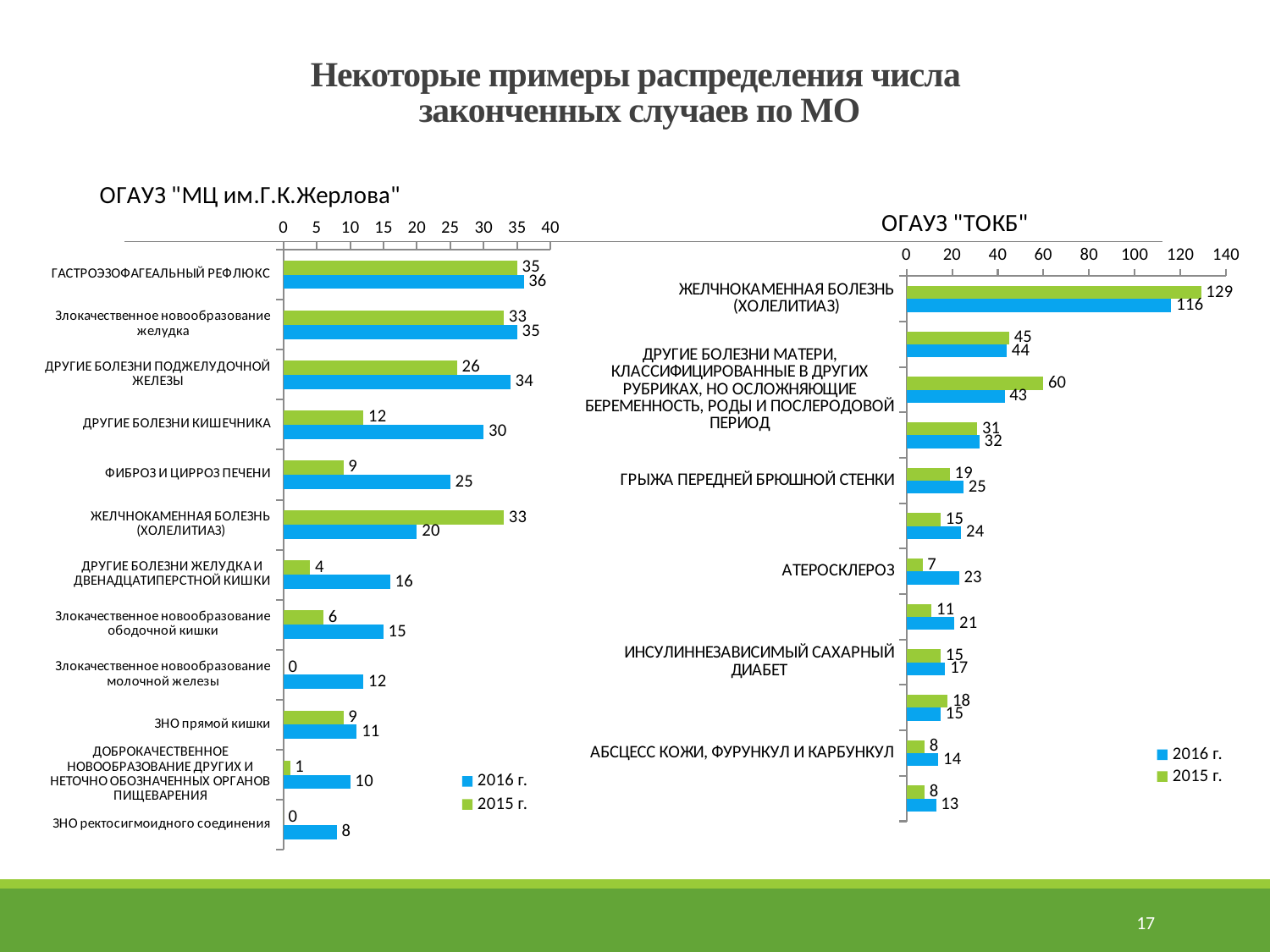
How many categories are shown in the chart titled ОГАУЗ "МЦ им.Г.К.Жерлова"? 12 In the chart titled ОГАУЗ "МЦ им.Г.К.Жерлова", what is the 2016 г. value for ГАСТРОЭЗОФАГЕАЛЬНЫЙ РЕФЛЮКС? 36 In the chart titled ОГАУЗ "ТОКБ", which colour represents 2015 г.? Green In the chart titled ОГАУЗ "МЦ им.Г.К.Жерлова", which is larger for ЖЕЛЧНОКАМЕННАЯ БОЛЕЗНЬ (ХОЛЕЛИТИАЗ): the 2015 г. value or the 2016 г. value? 2015 г. In the chart titled ОГАУЗ "ТОКБ", what is the difference between the 2016 г. and 2015 г. values for ГРЫЖА ПЕРЕДНЕЙ БРЮШНОЙ СТЕНКИ? 6 What type of chart is the chart titled ОГАУЗ "ТОКБ"? Bar chart In the chart titled ОГАУЗ "МЦ им.Г.К.Жерлова", what is the 2015 г. value for ФИБРОЗ И ЦИРРОЗ ПЕЧЕНИ? 9 In the chart titled ОГАУЗ "ТОКБ", what is the 2015 г. value for ЖЕЛЧНОКАМЕННАЯ БОЛЕЗНЬ (ХОЛЕЛИТИАЗ)? 129 How many series does the legend list in the chart titled ОГАУЗ "ТОКБ"? 2 In the chart titled ОГАУЗ "ТОКБ", what is the 2016 г. value for АТЕРОСКЛЕРОЗ? 23 In the chart titled ОГАУЗ "МЦ им.Г.К.Жерлова", which category has the highest 2016 г. value? ГАСТРОЭЗОФАГЕАЛЬНЫЙ РЕФЛЮКС In the chart titled ОГАУЗ "МЦ им.Г.К.Жерлова", what is the difference between the 2016 г. and 2015 г. values for ДРУГИЕ БОЛЕЗНИ КИШЕЧНИКА? 18